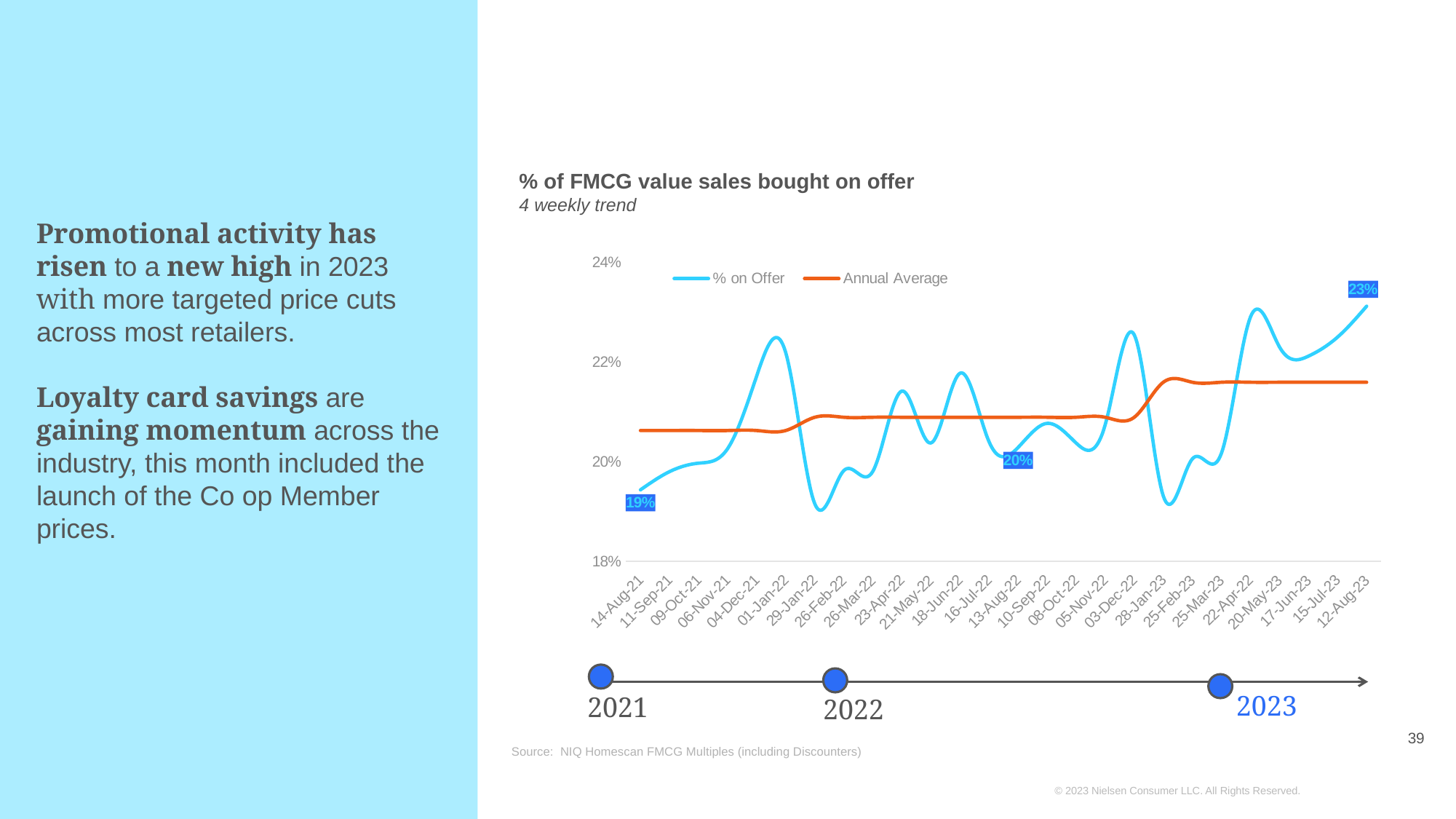
Which labelled '% on Offer' value is larger: 14-Aug-21 or 12-Aug-23? 12-Aug-23 Is the '% on Offer' value at 29-Jan-22 greater or less than 20%? less Is the 'Annual Average' value in 2023 greater or less than 22%? less What is the data label shown at the end of the '% on Offer' line (12-Aug-23)? 23% What is the data label shown on the '% on Offer' line at 13-Aug-22? 20% What is the title of the chart? % of FMCG value sales bought on offer Does the 'Annual Average' line rise or fall from 2021 to 2023? Rise What kind of chart is shown on the slide? Line chart How many series does the legend list? 2 Of the three labelled points on the '% on Offer' line, which date has the highest value? 12-Aug-23 By how many percentage points does the labelled '% on Offer' value at 12-Aug-23 exceed the labelled value at 14-Aug-21? 4 percentage points What is the data label shown at the start of the '% on Offer' line (14-Aug-21)? 19%